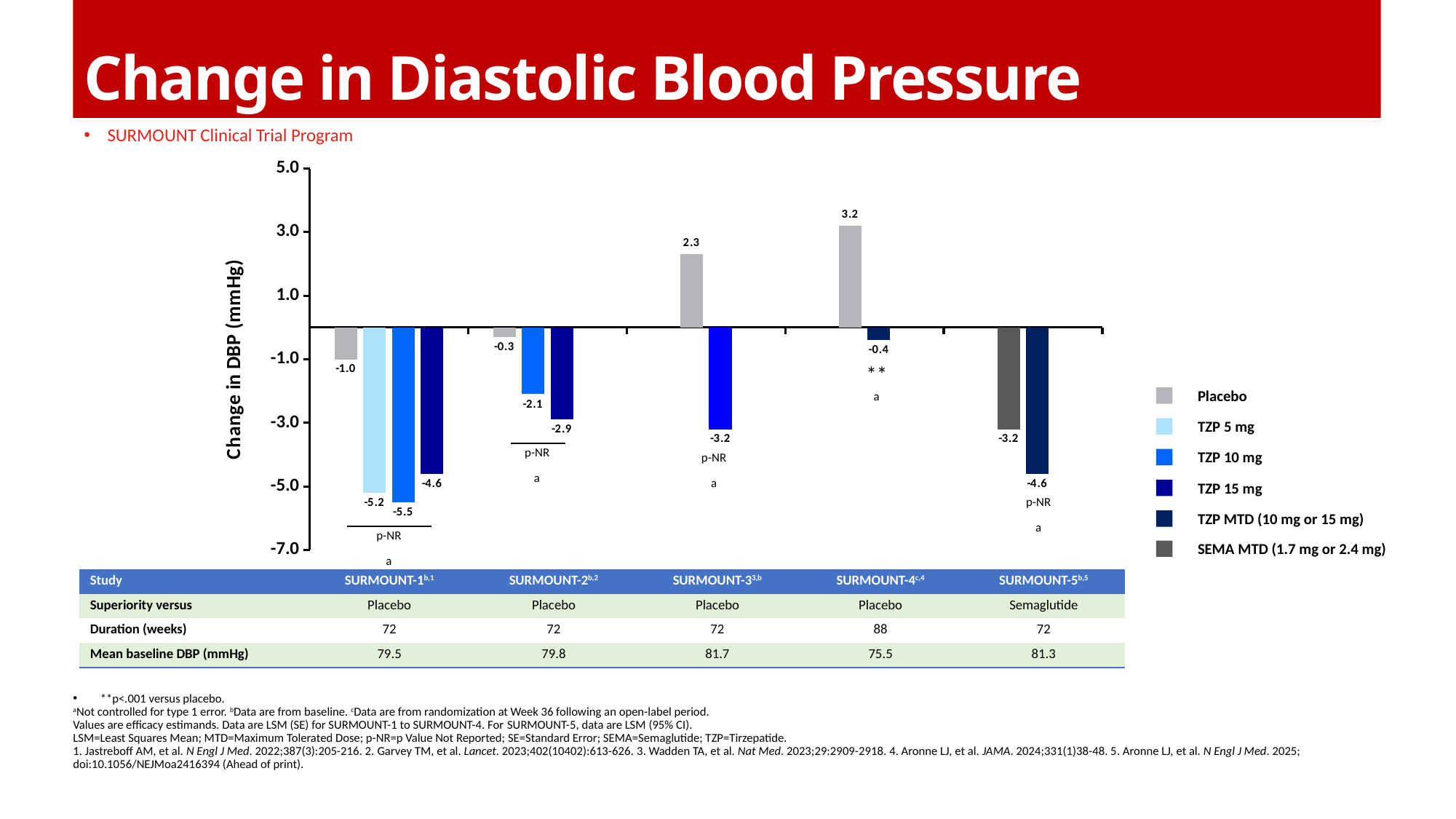
What is the change in DBP for TZP 5 mg in SURMOUNT-1? -5.2 What is the change in DBP for SEMA MTD in SURMOUNT-5? -3.2 What is the difference between the TZP 10 mg and TZP 15 mg values in SURMOUNT-1? 0.9 What is the change in DBP for the Placebo group in SURMOUNT-1? -1.0 Which study has the larger Placebo change in DBP, SURMOUNT-3 or SURMOUNT-4? SURMOUNT-4 What type of chart is shown on the slide? Bar chart In which study does the Placebo group have the highest change in DBP? SURMOUNT-4 In SURMOUNT-5, how much larger is the DBP reduction for TZP MTD than for SEMA MTD? 1.4 How many series does the legend list? 6 What is the change in DBP for the Placebo group in SURMOUNT-4? 3.2 What is the change in DBP for TZP 15 mg in SURMOUNT-2? -2.9 Which bar shows the lowest change in DBP on the chart? TZP 10 mg in SURMOUNT-1 (-5.5)